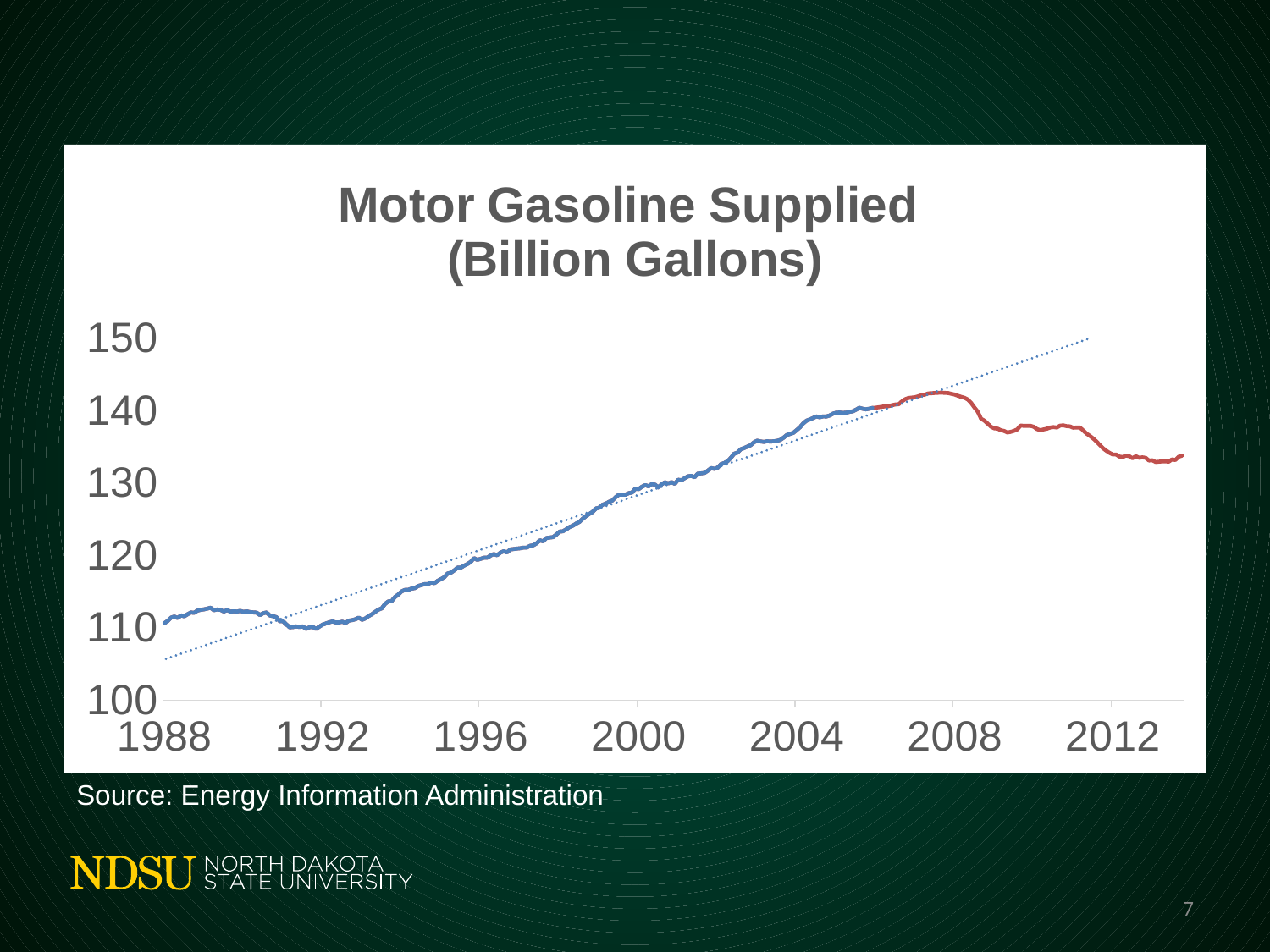
Is the value for 1988 greater or less than 100? greater Which is larger, the value for 1988 or the value for 2004? 2004 Is the value at the end of the red line (around 2013) greater or less than 130? greater Does the red portion of the line generally rise or fall from 2008 to 2013? fall Which is larger, the value for 2008 or the value for 2012? 2008 What kind of chart is shown on the slide? line chart Is the value at the end of the red line (around 2013) greater or less than 140? less Does the blue portion of the line generally rise or fall from 1988 to 2006? rise What is the source cited below the chart? Energy Information Administration What is the title of the chart? Motor Gasoline Supplied (Billion Gallons)